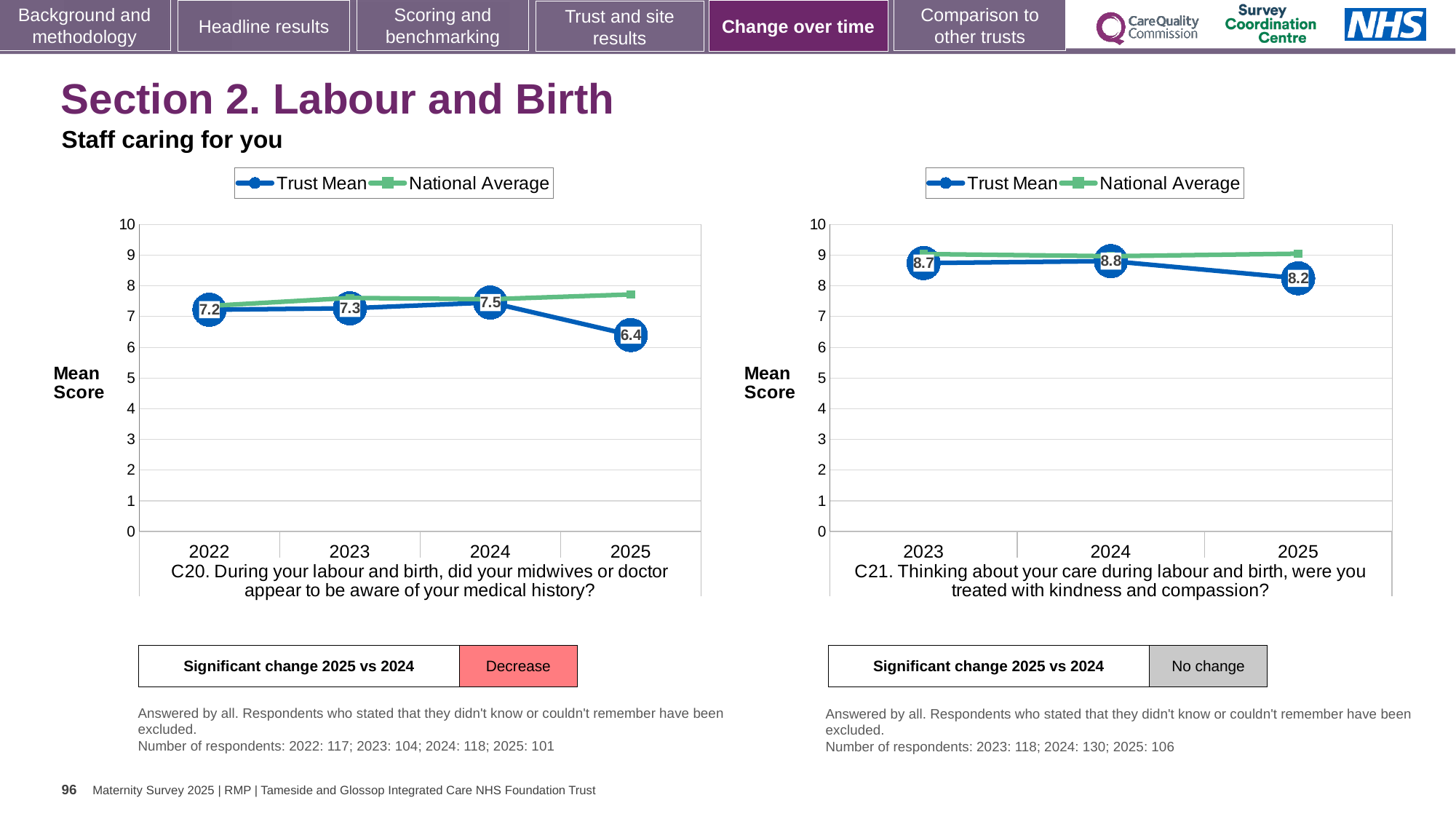
In the C21 chart (right), which year has the lowest Trust Mean? 2025 How many years are plotted on the x axis of the C20 chart (left)? 4 In the C20 chart (left), what is the Trust Mean for 2025? 6.4 What kind of chart is the C20 chart (left)? Line chart How many series does the legend of the C21 chart (right) list? 2 In the C21 chart (right), is the National Average for 2025 greater or less than 8? greater In the C21 chart (right), what is the Trust Mean for 2024? 8.8 In the C20 chart (left), what is the difference between the Trust Mean for 2024 and 2025? 1.1 In the C20 chart (left), which year has the highest Trust Mean? 2024 In the C20 chart (left), what is the Trust Mean for 2022? 7.2 In the C21 chart (right), which is larger, the Trust Mean for 2023 or for 2025? 2023 In the C20 chart (left), does the National Average rise or fall from 2022 to 2025? Rise